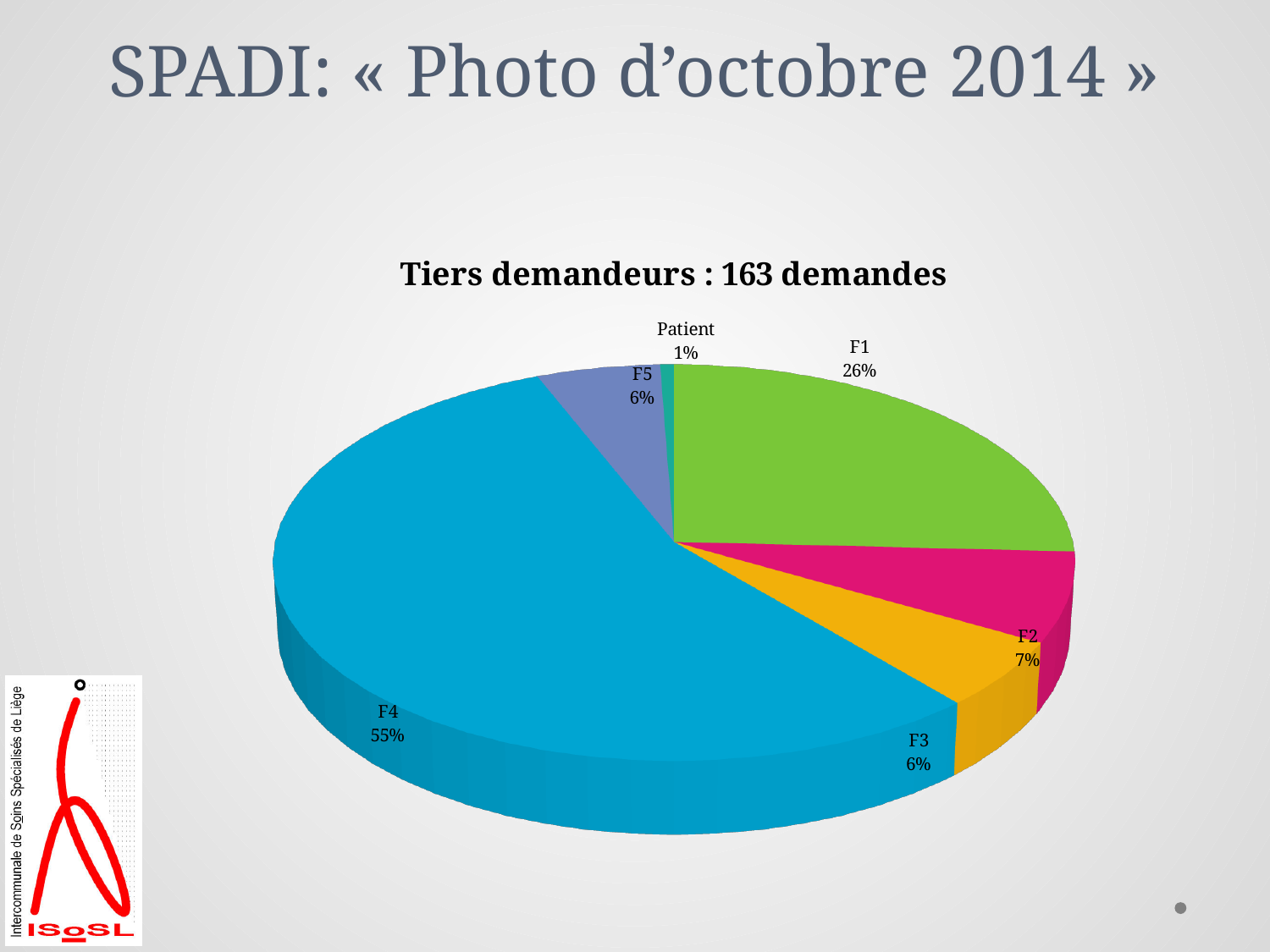
What share of the pie does F4 represent? 55% Which is larger, the share for F1 or the share for F2? F1 What kind of chart is shown on the slide? Pie chart How many slices does the pie chart have? 6 What is the title of the chart? Tiers demandeurs : 163 demandes What is the value shown for Patient? 1% What is the difference in percentage points between F4 and F1? 29 What share of the pie does F1 represent? 26% Which category has the largest slice of the pie? F4 Which category has the smallest slice of the pie? Patient What is the value shown for F2? 7% What colour is the F4 slice? Blue